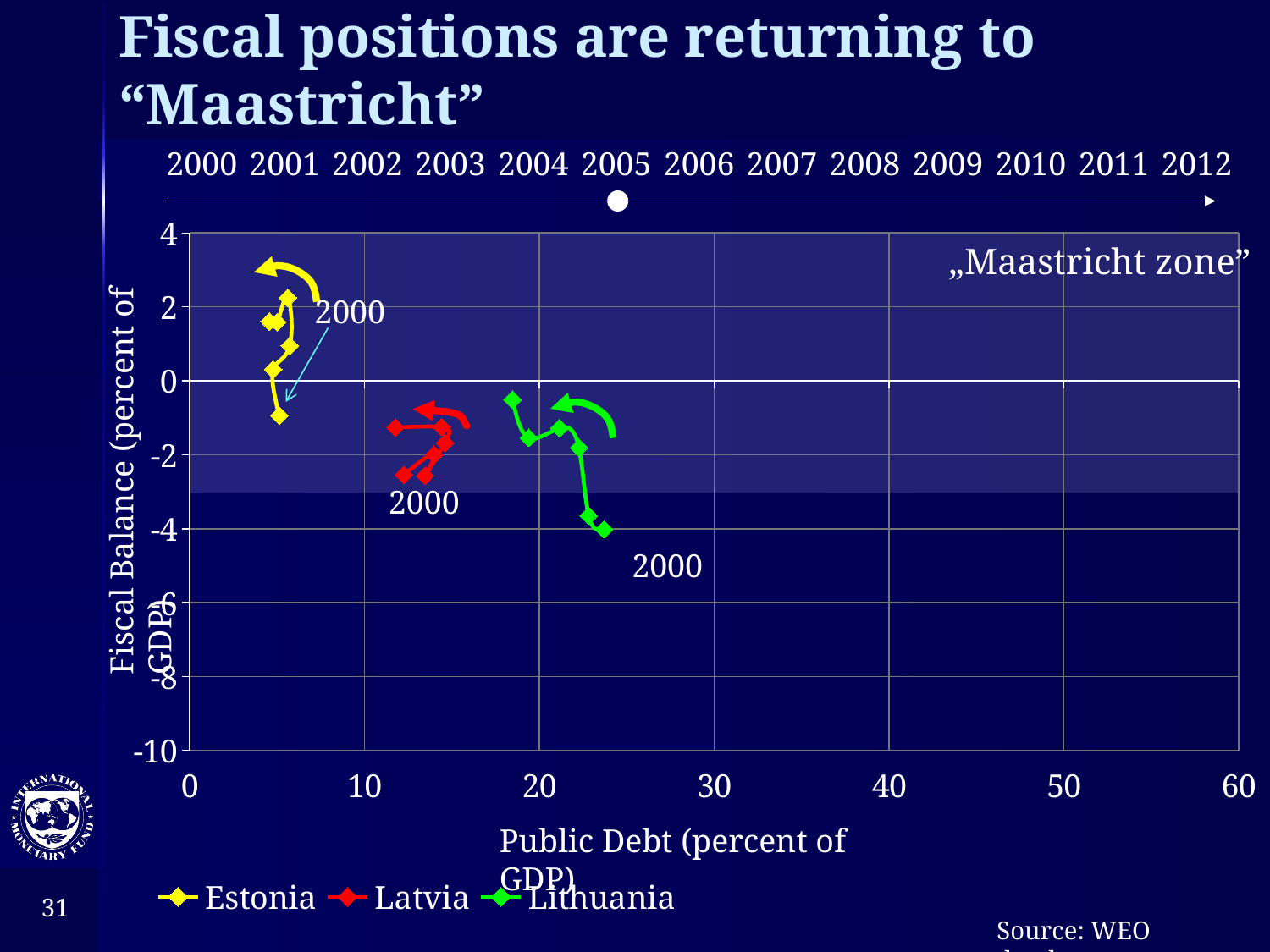
What is the label of the horizontal axis? Public Debt (percent of GDP) Is the fiscal balance for Lithuania in 2000 greater or less than -2? less Is the public debt for Latvia greater or less than 20? less Which country has the highest public debt among the three plotted? Lithuania Which country has the lowest public debt among the three plotted? Estonia Which has the larger public debt, Latvia or Lithuania? Lithuania Is the public debt for Lithuania greater or less than 30? less What kind of chart is shown on the slide? scatter chart Which countries are listed in the chart legend? Estonia, Latvia, Lithuania How many series does the legend list? 3